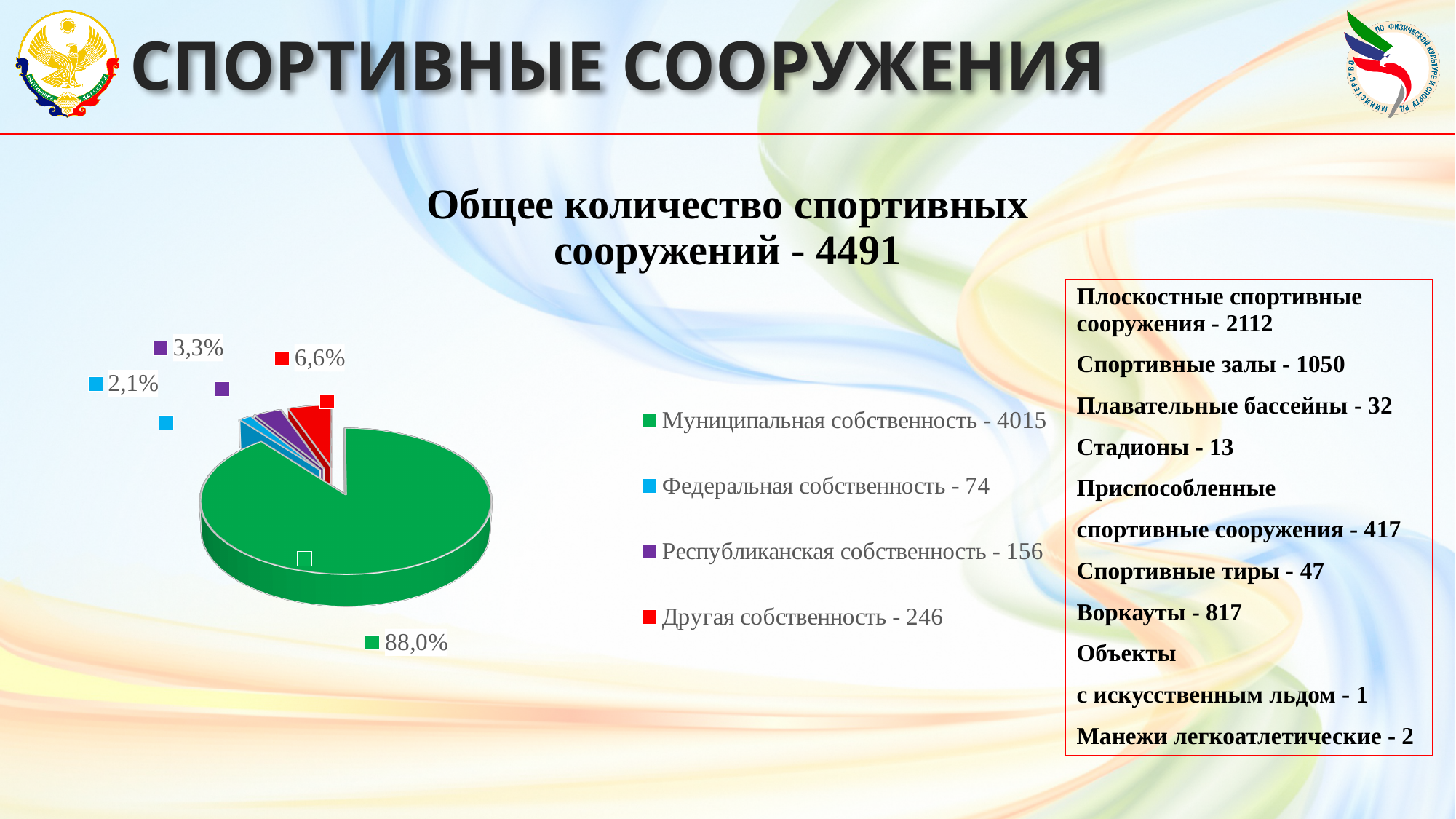
What number is given in the legend for Муниципальная собственность? 4015 Which slice is larger: Другая собственность or Республиканская собственность? Другая собственность What is the difference in percentage points between the Другая собственность slice and the Республиканская собственность slice? 3,3% What percentage is shown for Федеральная собственность in the pie chart? 2,1% What percentage is shown for Другая собственность in the pie chart? 6,6% How many entries does the legend of the pie chart list? 4 What percentage is shown for Муниципальная собственность in the pie chart? 88,0% Which category has the smallest slice in the pie chart? Федеральная собственность What percentage is shown for Республиканская собственность in the pie chart? 3,3% How many slices does the pie chart have? 4 Which category has the largest slice in the pie chart? Муниципальная собственность What kind of chart is shown on the slide? Pie chart